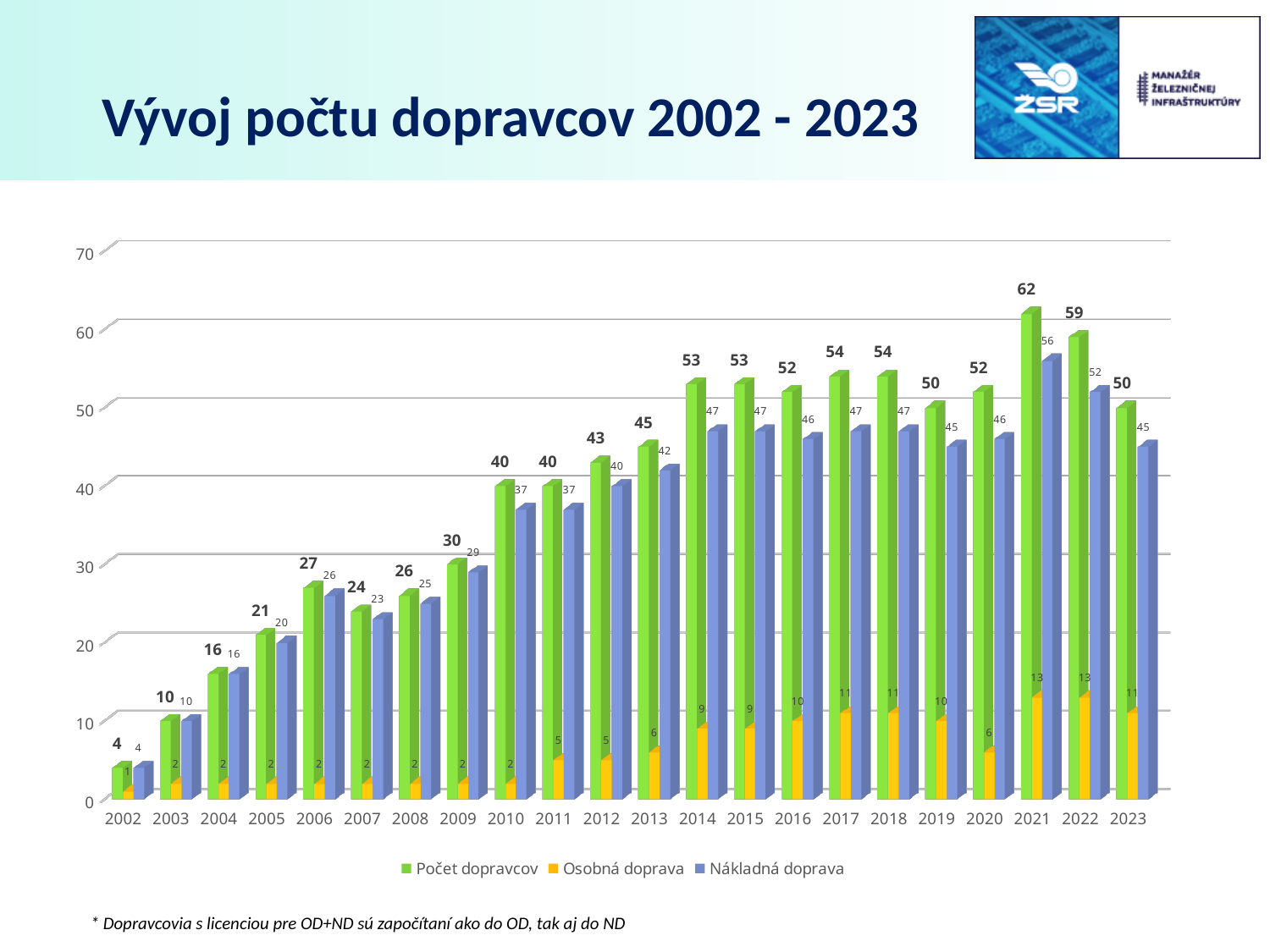
In which year is Nákladná doprava lowest? 2002 Does Počet dopravcov rise or fall from 2002 to 2010? Rise What is the title of the chart? Vývoj počtu dopravcov 2002 - 2023 What is the value of Osobná doprava for 2016? 10 What is the value of Počet dopravcov for 2021? 62 How many years are shown on the x axis? 22 In which year is Počet dopravcov highest? 2021 What is the value of Nákladná doprava for 2013? 42 What is the difference between Počet dopravcov in 2021 and in 2023? 12 Which is larger: Osobná doprava in 2022 or Osobná doprava in 2020? 2022 What kind of chart is shown on the slide? Bar chart How many series does the legend list? 3